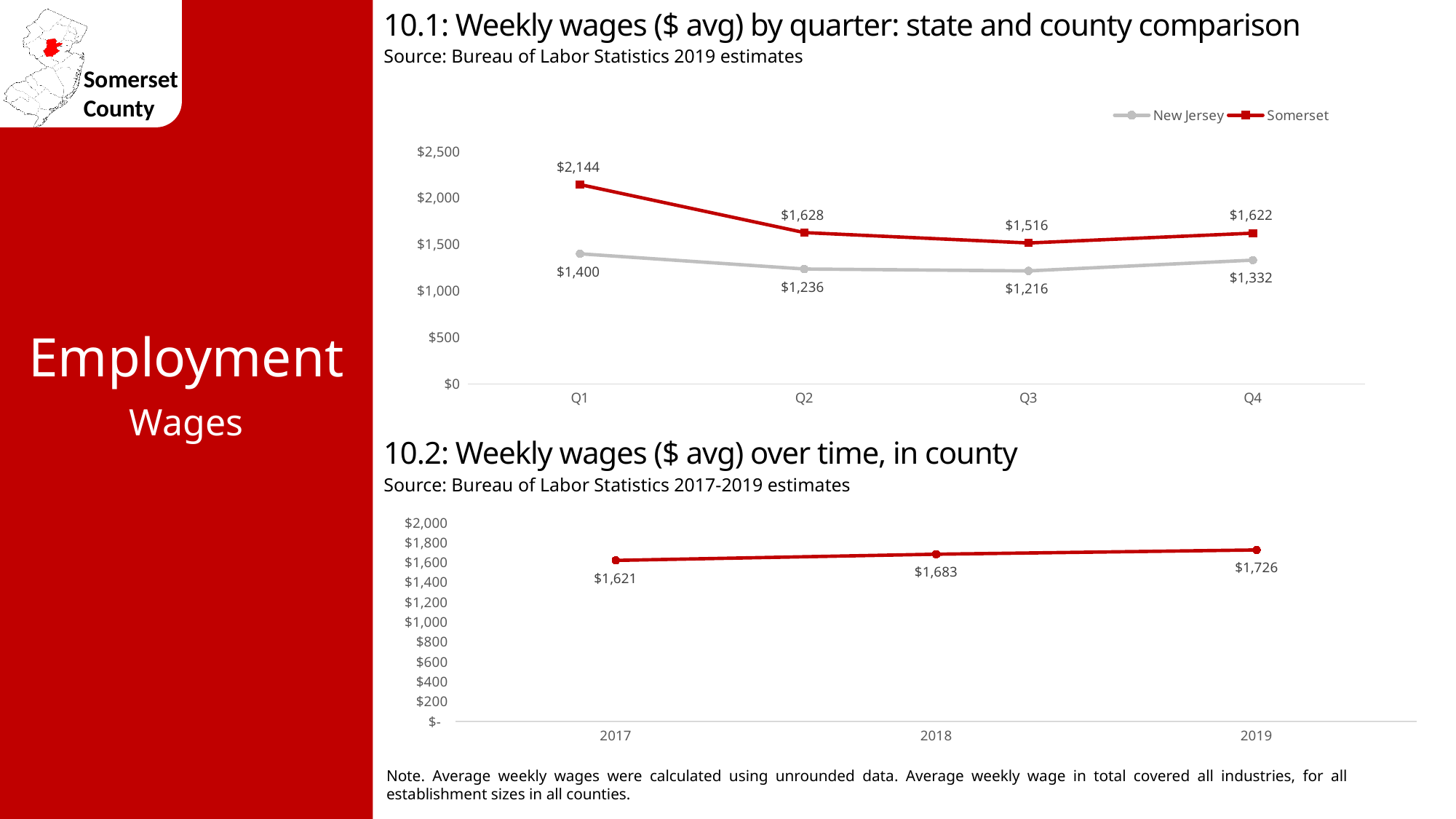
In chart 10.1 (Weekly wages by quarter: state and county comparison), what is the New Jersey value for Q3? $1,216 In chart 10.1 (Weekly wages by quarter: state and county comparison), what kind of chart is it? Line chart In chart 10.1 (Weekly wages by quarter: state and county comparison), which quarter has the lowest New Jersey value? Q3 In chart 10.2 (Weekly wages over time, in county), what is the difference between the 2019 and 2017 values? $105 In chart 10.2 (Weekly wages over time, in county), do the values rise or fall from 2017 to 2019? Rise In chart 10.1 (Weekly wages by quarter: state and county comparison), what is the Somerset value for Q1? $2,144 In chart 10.1 (Weekly wages by quarter: state and county comparison), what is the difference between the Somerset and New Jersey values in Q4? $290 In chart 10.2 (Weekly wages over time, in county), what is the value for 2018? $1,683 In chart 10.2 (Weekly wages over time, in county), how many years are plotted? 3 In chart 10.1 (Weekly wages by quarter: state and county comparison), how many series does the legend list? 2 In chart 10.1 (Weekly wages by quarter: state and county comparison), which is larger in Q2: Somerset or New Jersey? Somerset In chart 10.1 (Weekly wages by quarter: state and county comparison), which quarter has the highest Somerset value? Q1